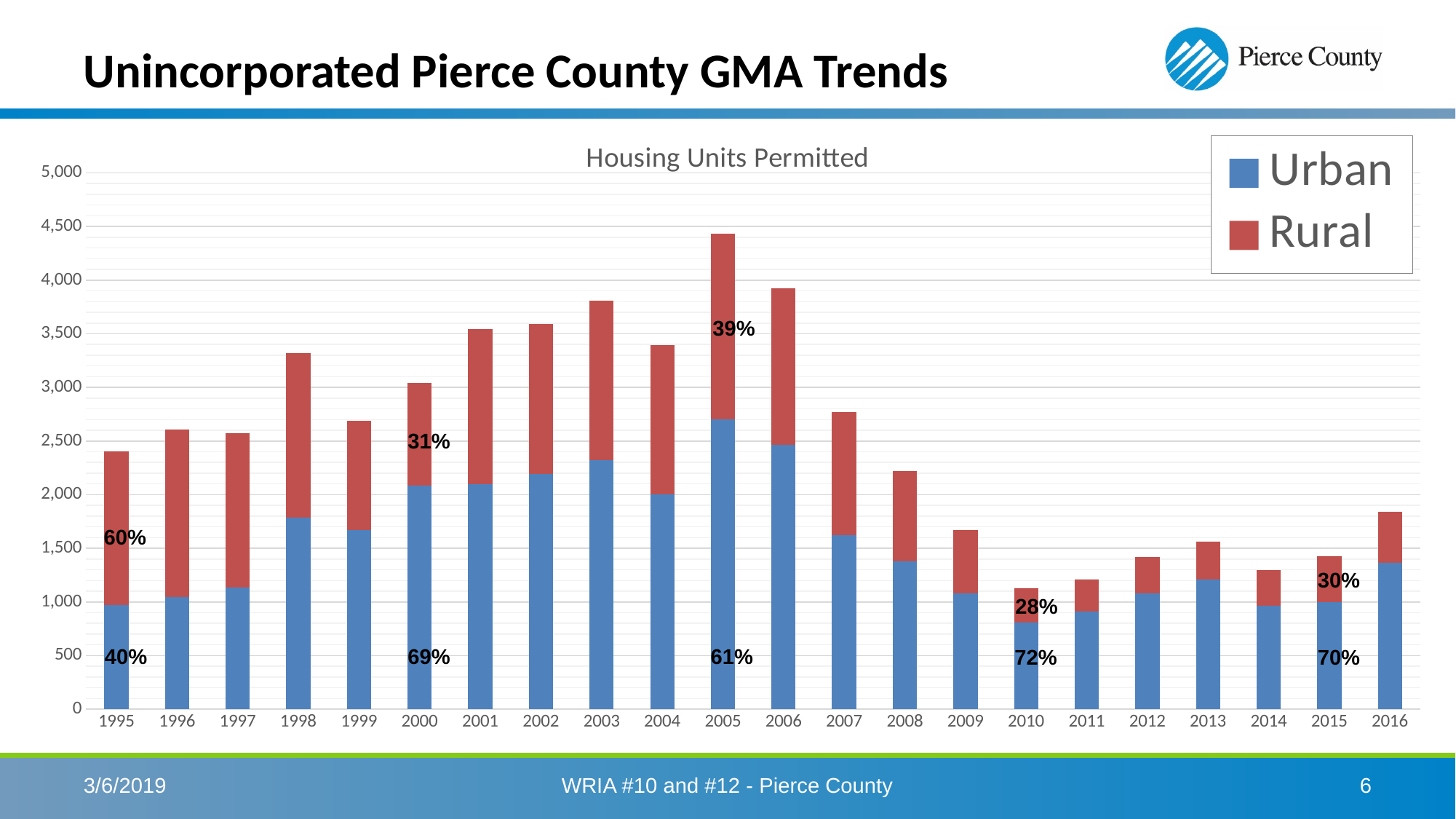
Is the total housing units permitted in 2005 greater or less than 4,000? greater How many years are shown on the x axis of the chart? 22 Is the total housing units permitted in 2010 greater or less than 1,500? less How many series does the legend list? 2 What is the title of the chart? Housing Units Permitted Which year has the highest total of housing units permitted? 2005 What percentage label is shown for the Rural portion of the 2000 bar? 31% What percentage label is shown for the Urban portion of the 1995 bar? 40% What kind of chart is shown on the slide? Stacked bar chart Do the total housing units permitted rise or fall from 2005 to 2010? fall What percentage label is shown for the Rural portion of the 2015 bar? 30% What percentage label is shown for the Urban portion of the 2010 bar? 72%